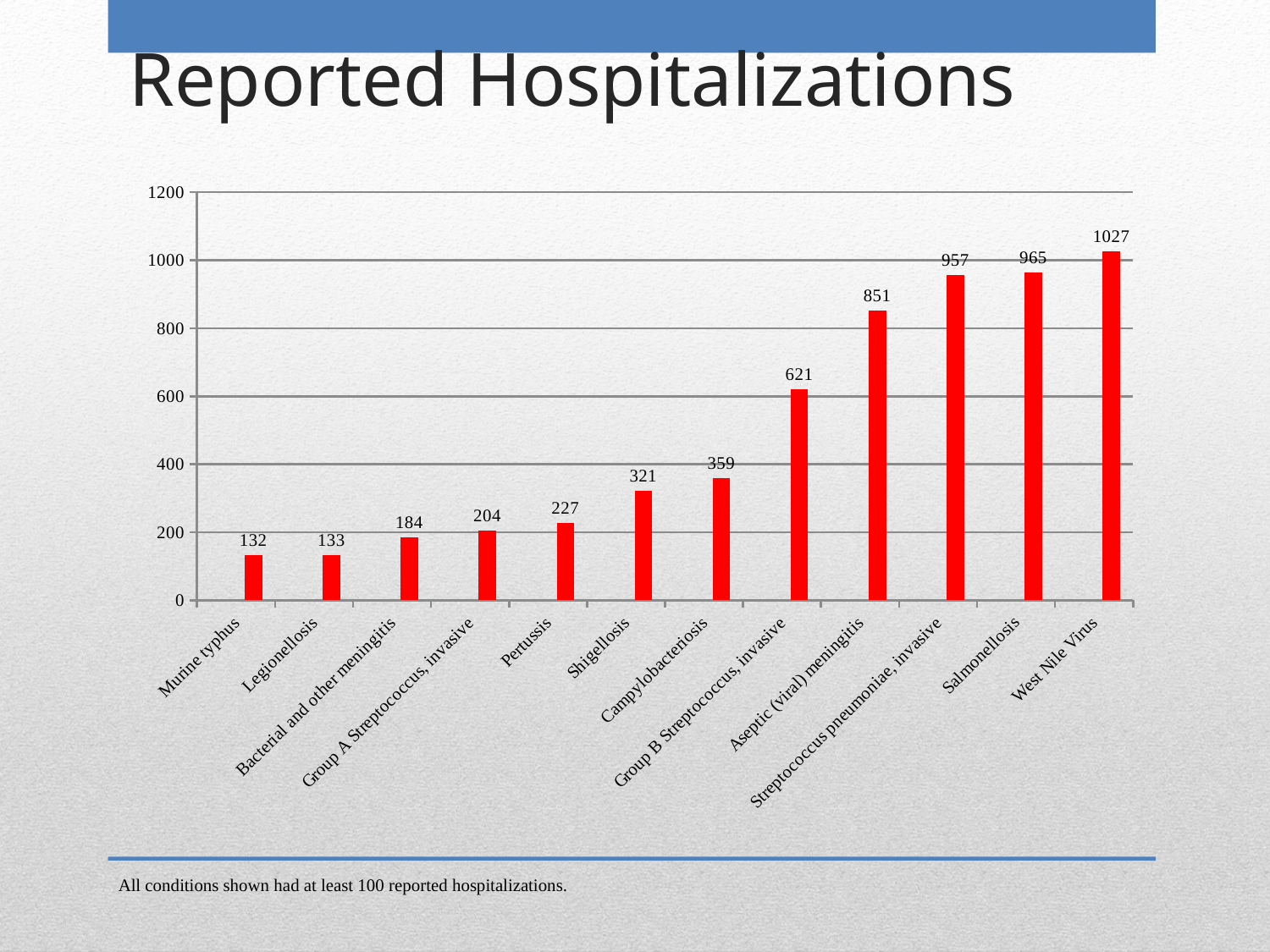
What kind of chart is shown on the slide? bar chart How many reported hospitalizations are shown for Pertussis? 227 Which condition has the highest number of reported hospitalizations? West Nile Virus Which has more reported hospitalizations, Shigellosis or Bacterial and other meningitis? Shigellosis Is the value for Campylobacteriosis greater or less than 400? less What is the difference between the values for Group B Streptococcus, invasive and Campylobacteriosis? 262 Do the values rise or fall from left to right along the x axis? rise What is the value for Aseptic (viral) meningitis? 851 How many conditions are shown on the chart? 12 What is the difference between the values for Salmonellosis and Streptococcus pneumoniae, invasive? 8 Which condition has the lowest number of reported hospitalizations? Murine typhus What is the value for Group A Streptococcus, invasive? 204